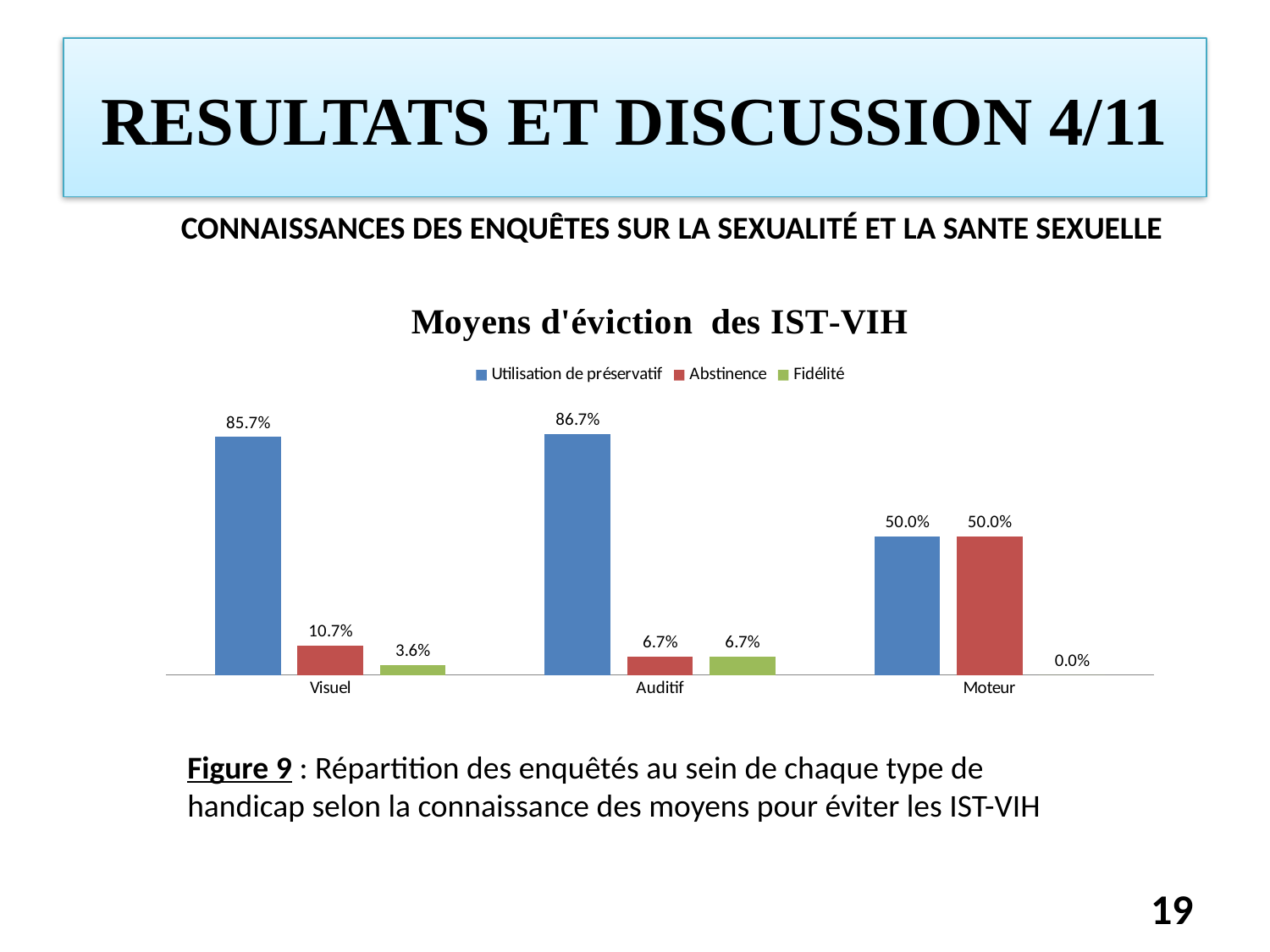
What kind of chart is shown? Bar chart How many categories are shown on the x axis? 3 Which category has the highest value for Utilisation de préservatif? Auditif What is the value for Fidélité in the Moteur category? 0.0% How many series does the legend list? 3 What is the value for Abstinence in the Auditif category? 6.7% What is the value for Utilisation de préservatif in the Visuel category? 85.7% What is the title of the chart? Moyens d'éviction des IST-VIH What is the difference between Utilisation de préservatif and Abstinence in the Visuel category? 75.0% Which is larger in the Moteur category: Utilisation de préservatif or Fidélité? Utilisation de préservatif Which category has the lowest value for Fidélité? Moteur What is the value for Fidélité in the Visuel category? 3.6%